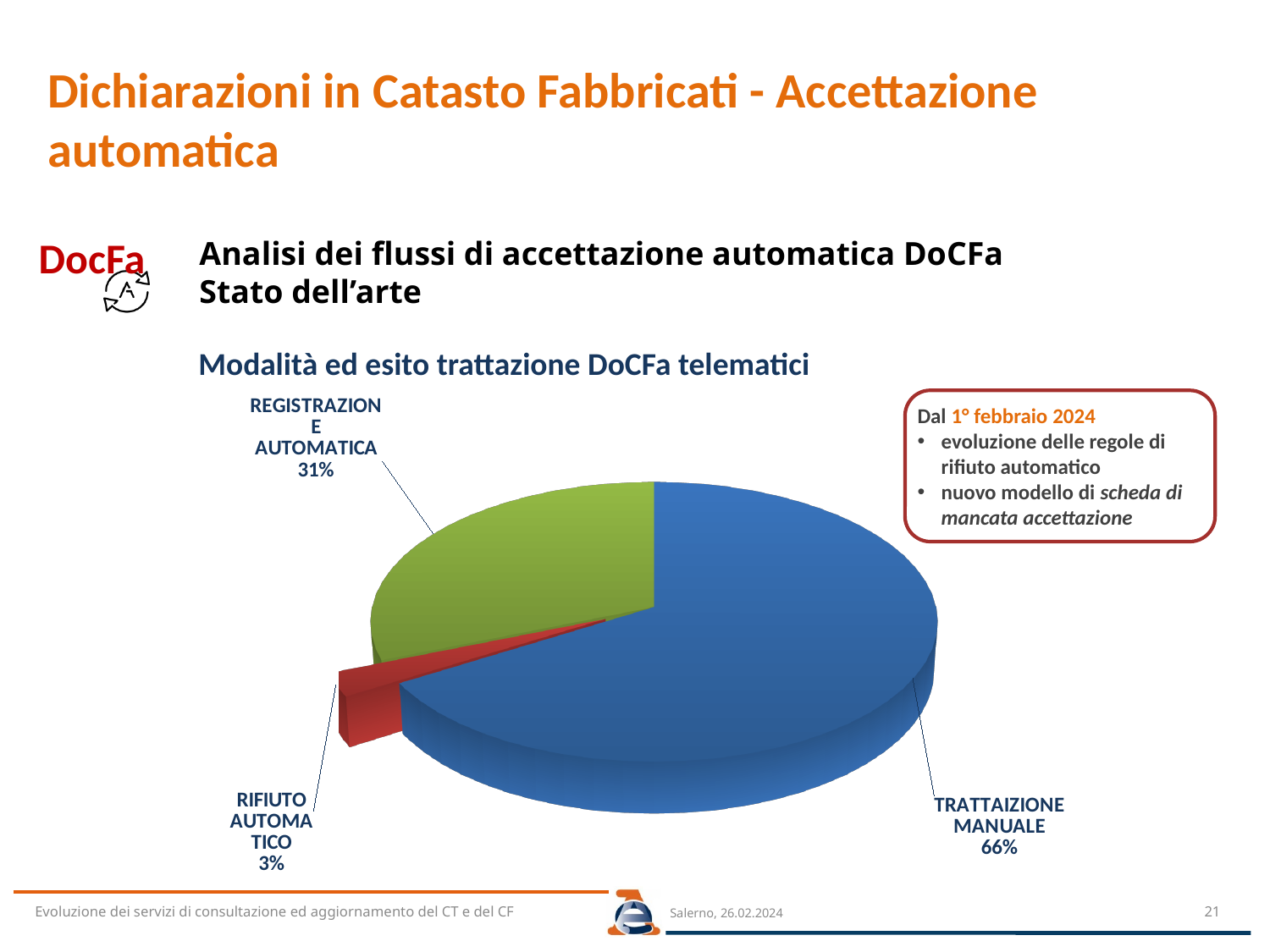
Which slice of the pie chart is the smallest? RIFIUTO AUTOMATICO Which is larger, REGISTRAZIONE AUTOMATICA or RIFIUTO AUTOMATICO? REGISTRAZIONE AUTOMATICA What is the difference in percentage points between TRATTAIZIONE MANUALE and REGISTRAZIONE AUTOMATICA? 35 What colour is the TRATTAIZIONE MANUALE slice? Blue What kind of chart is shown on the slide? Pie chart Which slice of the pie chart is the largest? TRATTAIZIONE MANUALE How many slices does the pie chart have? 3 What share of the pie is labelled TRATTAIZIONE MANUALE? 66% What is the title of the chart? Modalità ed esito trattazione DoCFa telematici What is the difference in percentage points between REGISTRAZIONE AUTOMATICA and RIFIUTO AUTOMATICO? 28 What share of the pie is labelled RIFIUTO AUTOMATICO? 3% What share of the pie is labelled REGISTRAZIONE AUTOMATICA? 31%